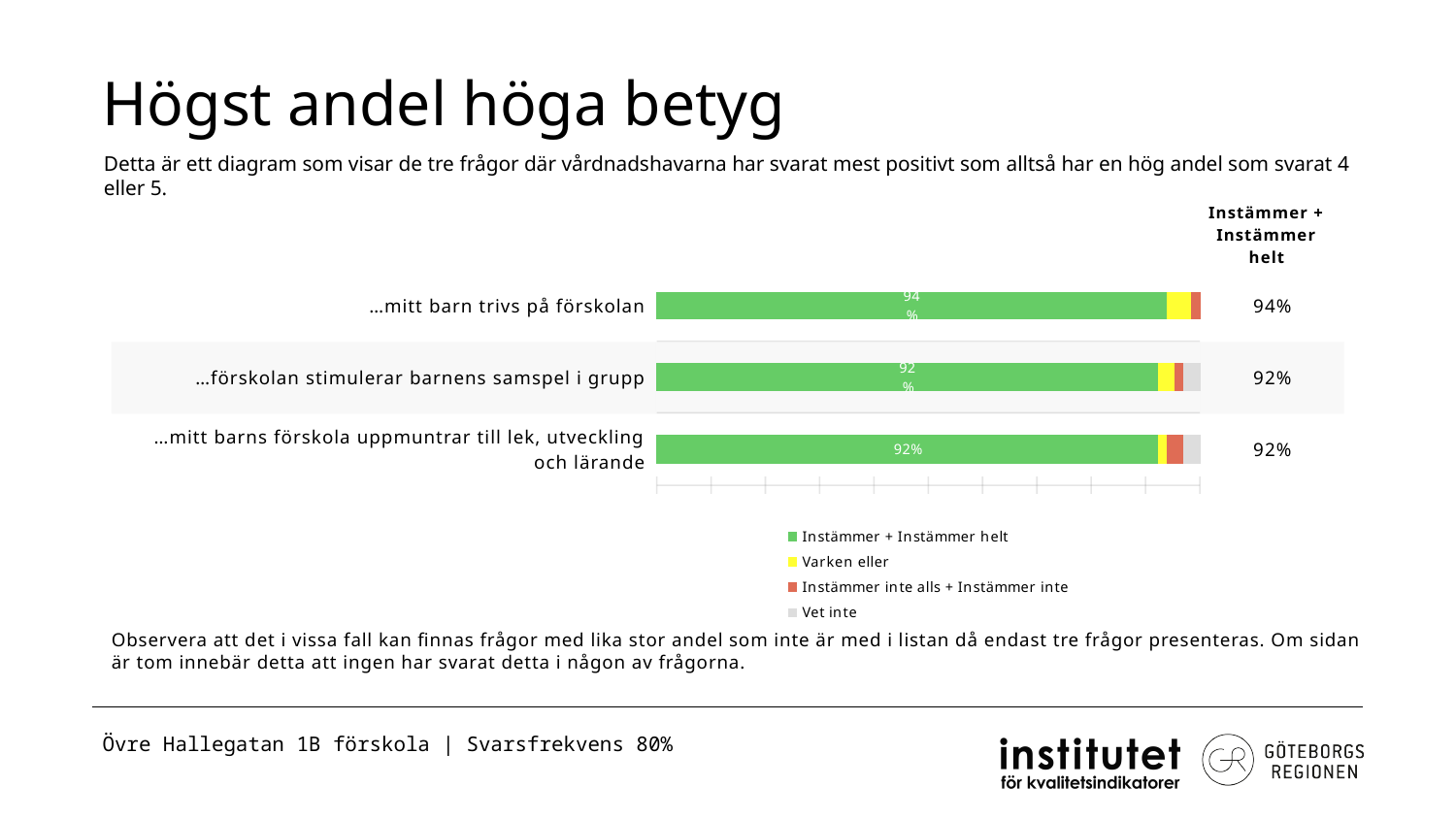
How many series does the legend list? 4 What is the heading of the column of values to the right of the bars? Instämmer + Instämmer helt How many categories (questions) are plotted in the chart? 3 What is the 'Instämmer + Instämmer helt' value for '…mitt barns förskola uppmuntrar till lek, utveckling och lärande'? 92% What is the 'Instämmer + Instämmer helt' value for '…mitt barn trivs på förskolan'? 94% What is the 'Instämmer + Instämmer helt' value for '…förskolan stimulerar barnens samspel i grupp'? 92% What is the difference in 'Instämmer + Instämmer helt' share between '…mitt barn trivs på förskolan' and '…förskolan stimulerar barnens samspel i grupp'? 2 percentage points What kind of chart is shown on the slide? bar chart Which has a larger 'Instämmer + Instämmer helt' share: '…mitt barn trivs på förskolan' or '…mitt barns förskola uppmuntrar till lek, utveckling och lärande'? …mitt barn trivs på förskolan Which legend entry is shown in green? Instämmer + Instämmer helt Which category has the highest 'Instämmer + Instämmer helt' share? …mitt barn trivs på förskolan What is the title of the slide containing the chart? Högst andel höga betyg